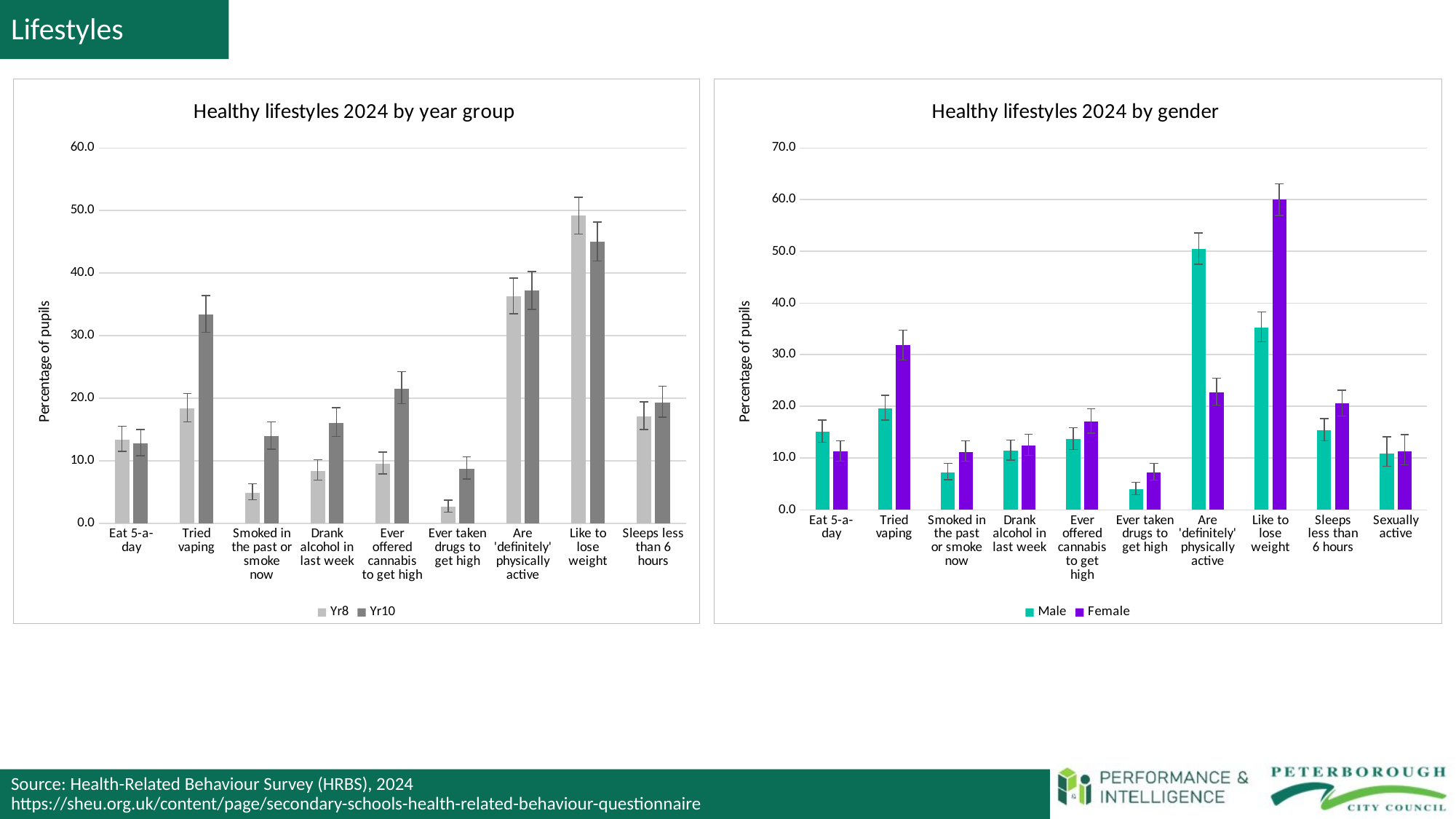
In 'Healthy lifestyles 2024 by year group', is the Yr10 value for 'Tried vaping' greater or less than 30.0? greater In 'Healthy lifestyles 2024 by gender', which category has the highest Male value? Are 'definitely' physically active How many categories are shown on the x axis of 'Healthy lifestyles 2024 by gender'? 10 In 'Healthy lifestyles 2024 by gender', is the Female value for 'Like to lose weight' greater or less than 50.0? greater How many categories are shown on the x axis of 'Healthy lifestyles 2024 by year group'? 9 In 'Healthy lifestyles 2024 by gender', which is larger for 'Are "definitely" physically active', Male or Female? Male In 'Healthy lifestyles 2024 by year group', which category has the lowest Yr8 value? Ever taken drugs to get high How many series does the legend of 'Healthy lifestyles 2024 by gender' list? 2 What kind of chart is 'Healthy lifestyles 2024 by year group'? bar chart In 'Healthy lifestyles 2024 by gender', which category has the highest Female value? Like to lose weight In 'Healthy lifestyles 2024 by year group', which category has the highest Yr8 value? Like to lose weight In 'Healthy lifestyles 2024 by gender', which category has the lowest Male value? Ever taken drugs to get high